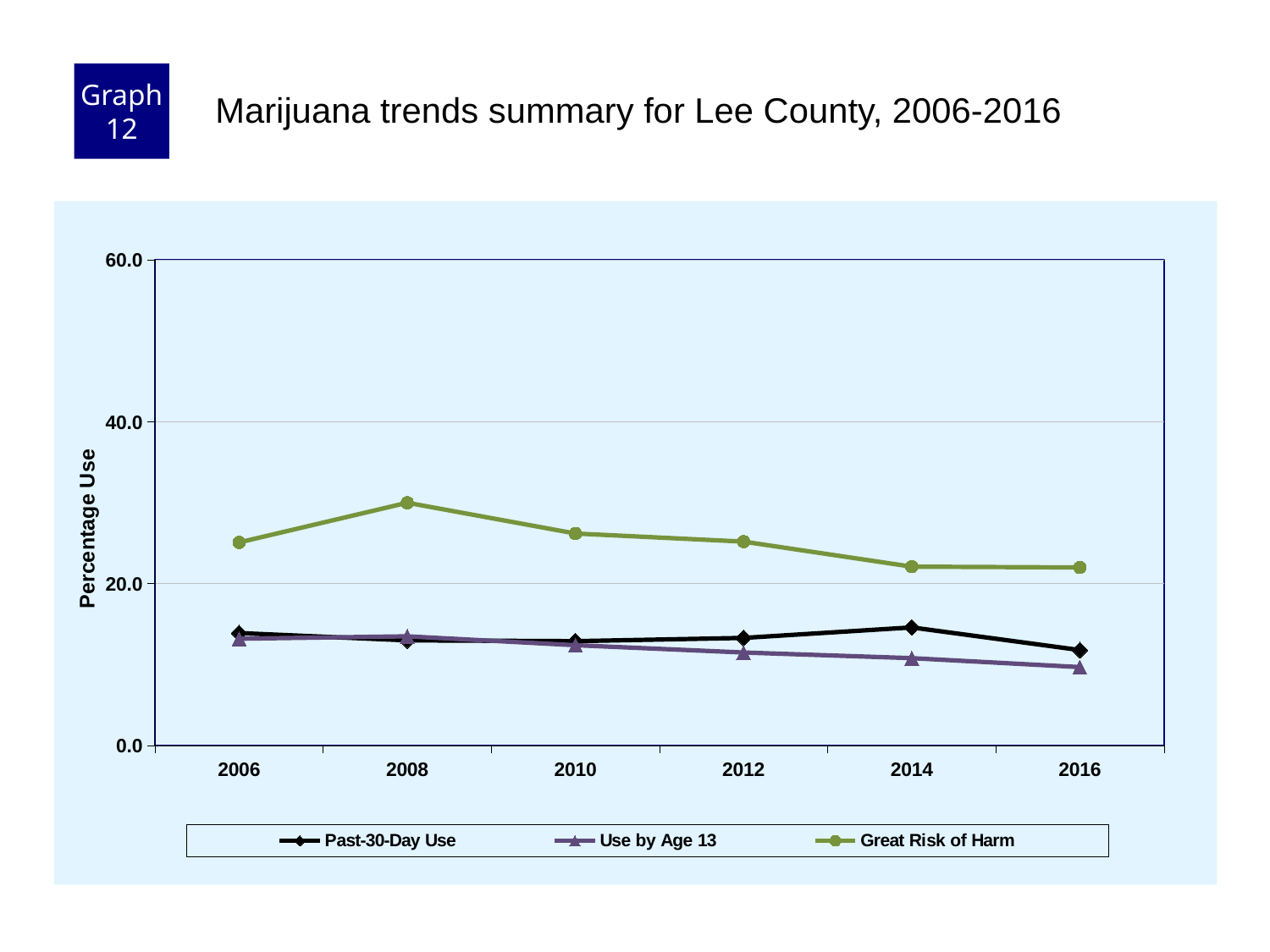
What kind of chart is shown on the slide? Line chart In which year is the Use by Age 13 series at its lowest? 2016 How many years are plotted along the x axis? 6 Is the value for Great Risk of Harm in 2008 greater or less than 40.0? less Which series is plotted with the highest values across all years? Great Risk of Harm How many series does the legend list? 3 Is the value for Great Risk of Harm in 2008 greater or less than 20.0? greater What is the label on the y axis? Percentage Use In which year does the Great Risk of Harm series reach its highest value? 2008 In 2014, which is larger: Past-30-Day Use or Use by Age 13? Past-30-Day Use Is the value for Past-30-Day Use in 2016 greater or less than 20.0? less Does the Use by Age 13 series rise or fall from 2006 to 2016? Fall